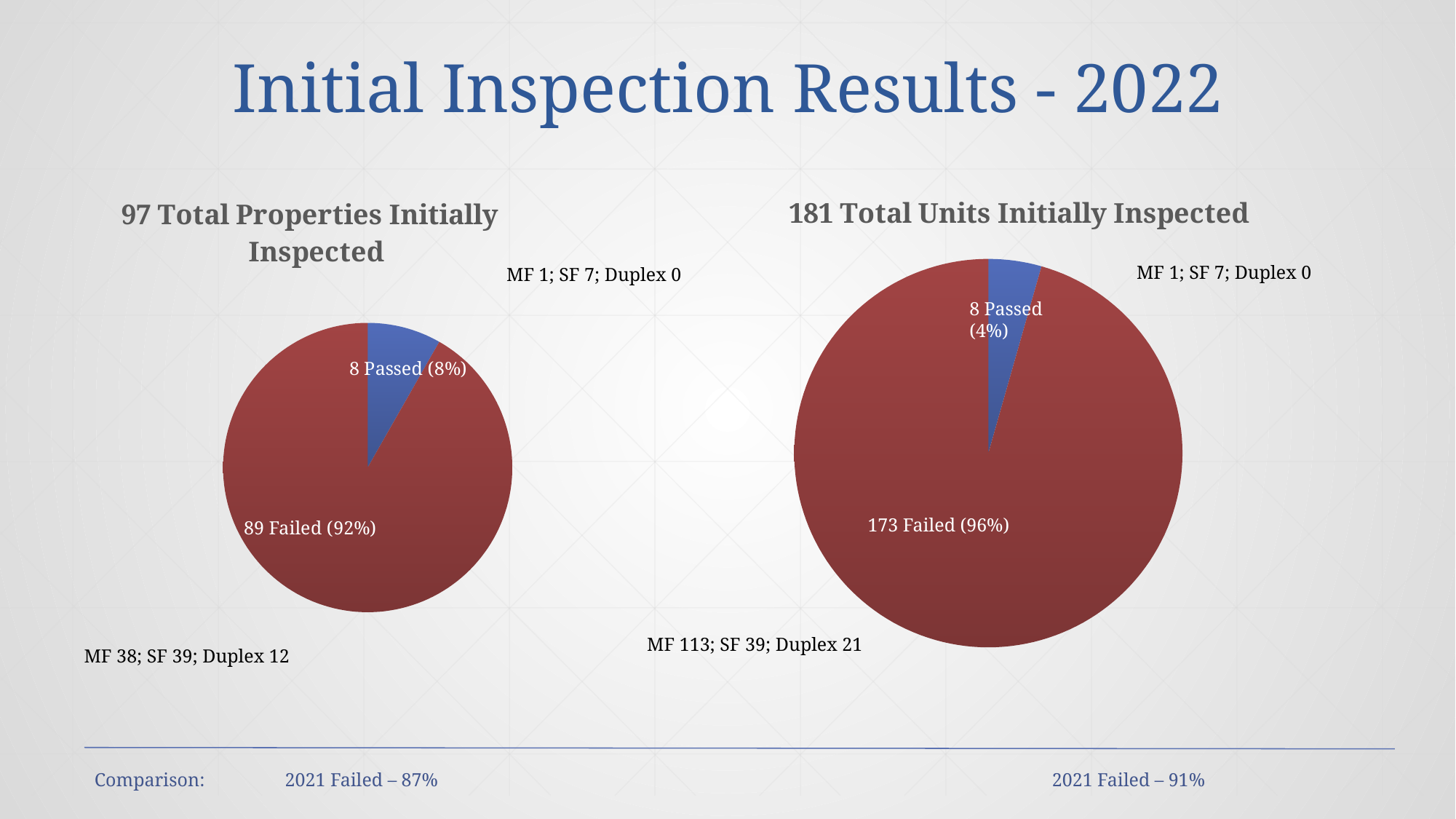
In the '181 Total Units Initially Inspected' chart, what share of units failed? 96% How many slices does each pie chart on the slide have? 2 In the '181 Total Units Initially Inspected' chart, how many units failed? 173 In the '181 Total Units Initially Inspected' chart, what is the difference between the number of failed and passed units? 165 In the '97 Total Properties Initially Inspected' chart, what is the difference between the number of failed and passed properties? 81 In the '97 Total Properties Initially Inspected' chart, which slice is larger, Passed or Failed? Failed What kind of chart is used on this slide? Pie chart In the '181 Total Units Initially Inspected' chart, how many units passed? 8 In the '97 Total Properties Initially Inspected' chart, what percentage of properties passed? 8% What colour is the Failed slice in both pie charts? Red In the '181 Total Units Initially Inspected' chart, which category is the smallest? Passed In the '97 Total Properties Initially Inspected' chart, how many properties failed? 89